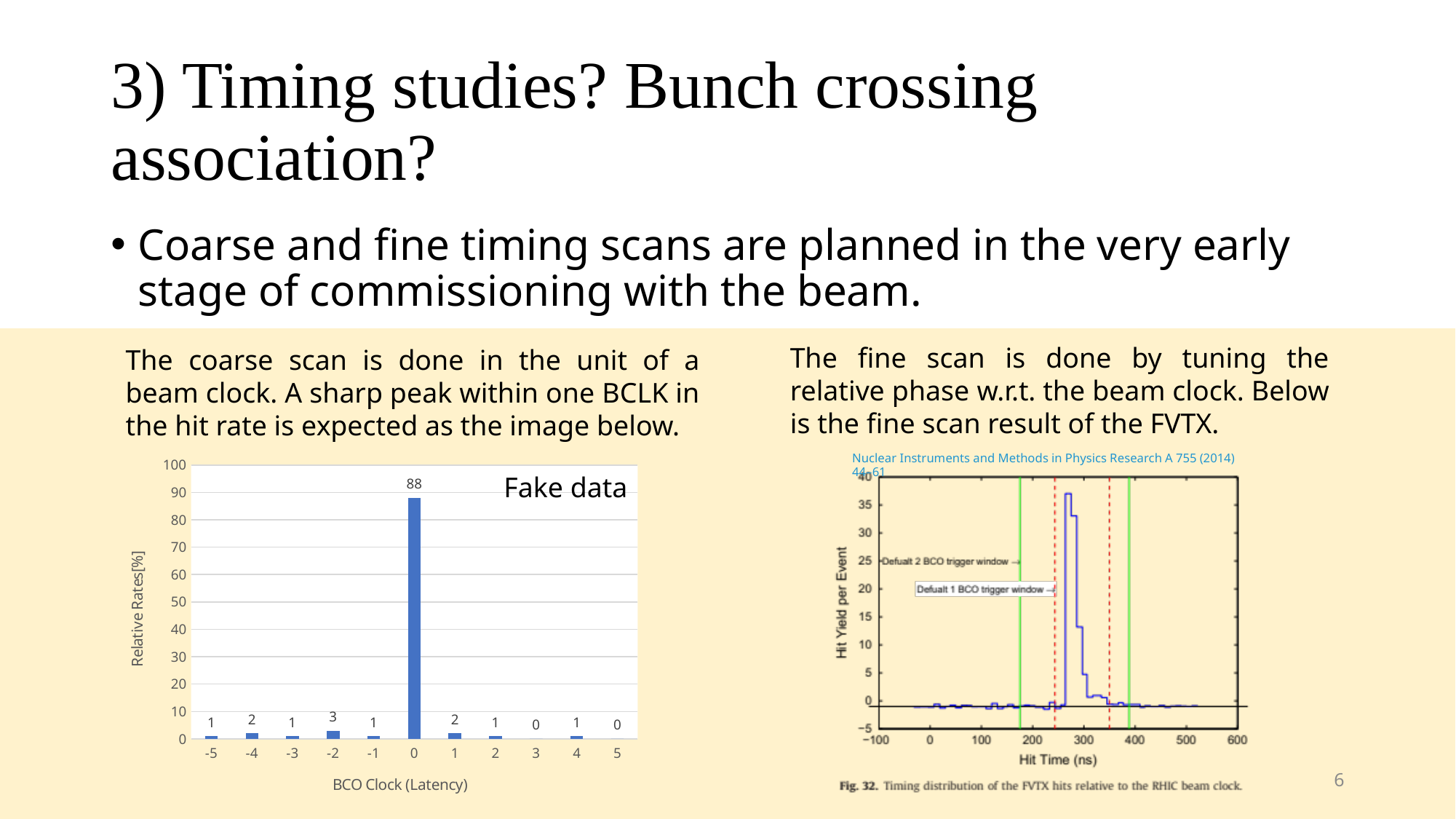
In the bar chart on the left, what text annotation appears in the upper right of the plot area? Fake data In the bar chart on the left, which BCO clock latency has the highest relative rate? 0 In the bar chart on the left, what is the relative rate at BCO clock latency 0? 88 What is the x-axis label of the chart on the right (Timing distribution of the FVTX hits)? Hit Time (ns) In the chart on the right (Timing distribution of the FVTX hits), is the peak hit yield per event greater or less than 30? greater What is the x-axis label of the bar chart on the left? BCO Clock (Latency) In the bar chart on the left, what is the relative rate at BCO clock latency -2? 3 In the bar chart on the left, how many BCO clock latency categories are shown on the x axis? 11 In the bar chart on the left, which has a larger relative rate: latency -4 or latency -2? -2 In the bar chart on the left, what is the difference between the relative rates at latency 0 and latency -2? 85 In the bar chart on the left, what is the relative rate at BCO clock latency 3? 0 What kind of chart is the chart on the left? bar chart